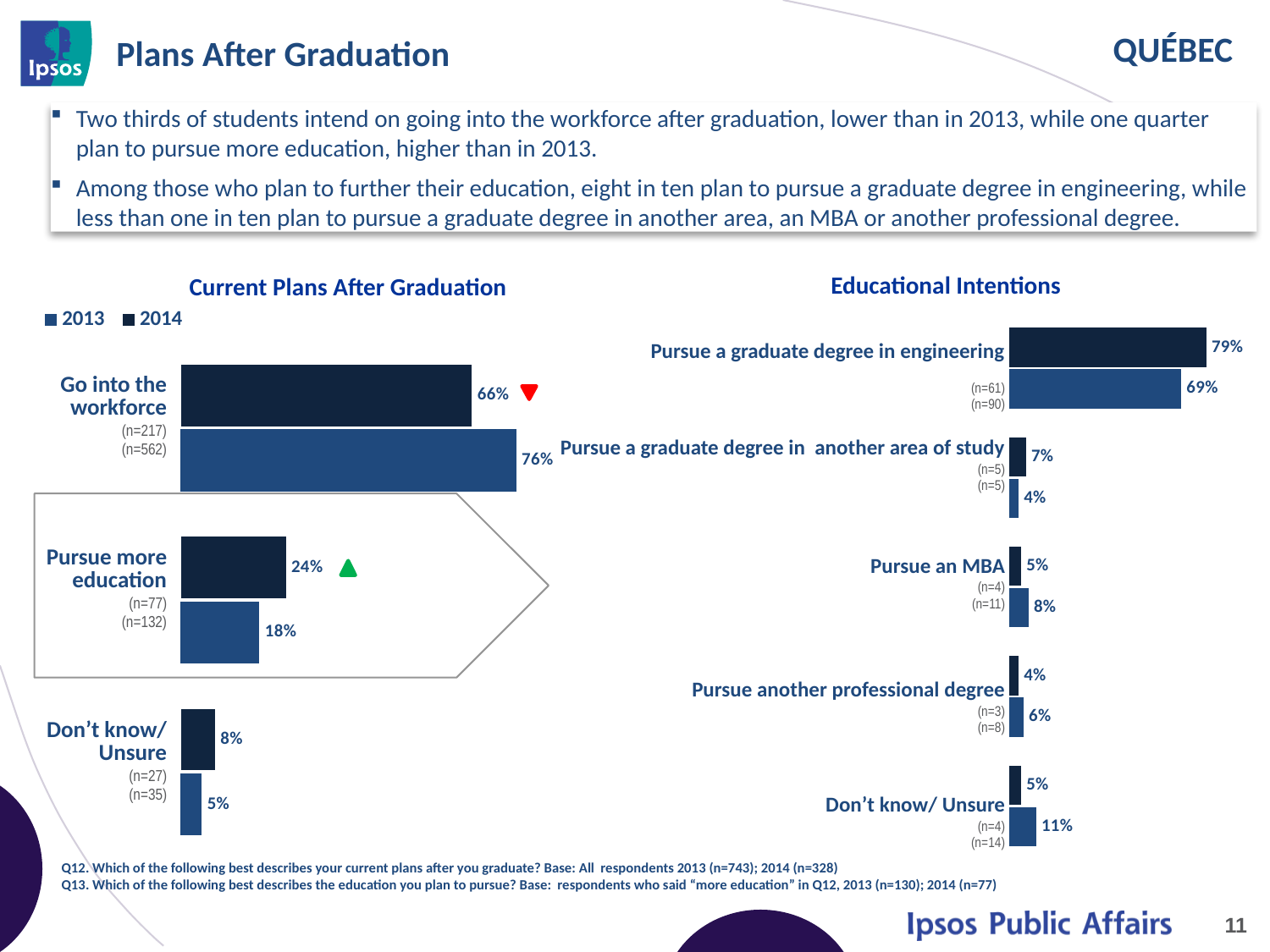
In the "Current Plans After Graduation" chart, what is the difference between the two bars for "Go into the workforce" (76% and 66%)? 10 percentage points In the "Educational Intentions" chart, what is the value of the lower bar for "Don't know/ Unsure"? 11% In the "Current Plans After Graduation" chart, what is the value of the lower bar for "Pursue more education"? 18% In the "Current Plans After Graduation" chart, which bar for "Don't know/ Unsure" is larger, the upper (8%) or the lower (5%)? the upper bar (8%) In the "Current Plans After Graduation" chart, what is the value of the upper bar for "Go into the workforce"? 66% In the "Educational Intentions" chart, which category has the highest values? Pursue a graduate degree in engineering How many categories are shown in the "Current Plans After Graduation" chart? 3 What are the two legend entries of the "Current Plans After Graduation" chart? 2013 and 2014 What kind of chart is the "Current Plans After Graduation" chart? bar chart How many categories are shown in the "Educational Intentions" chart? 5 How many series does the legend of the "Current Plans After Graduation" chart list? 2 In the "Educational Intentions" chart, what is the difference between the two bars for "Pursue a graduate degree in engineering" (79% and 69%)? 10 percentage points